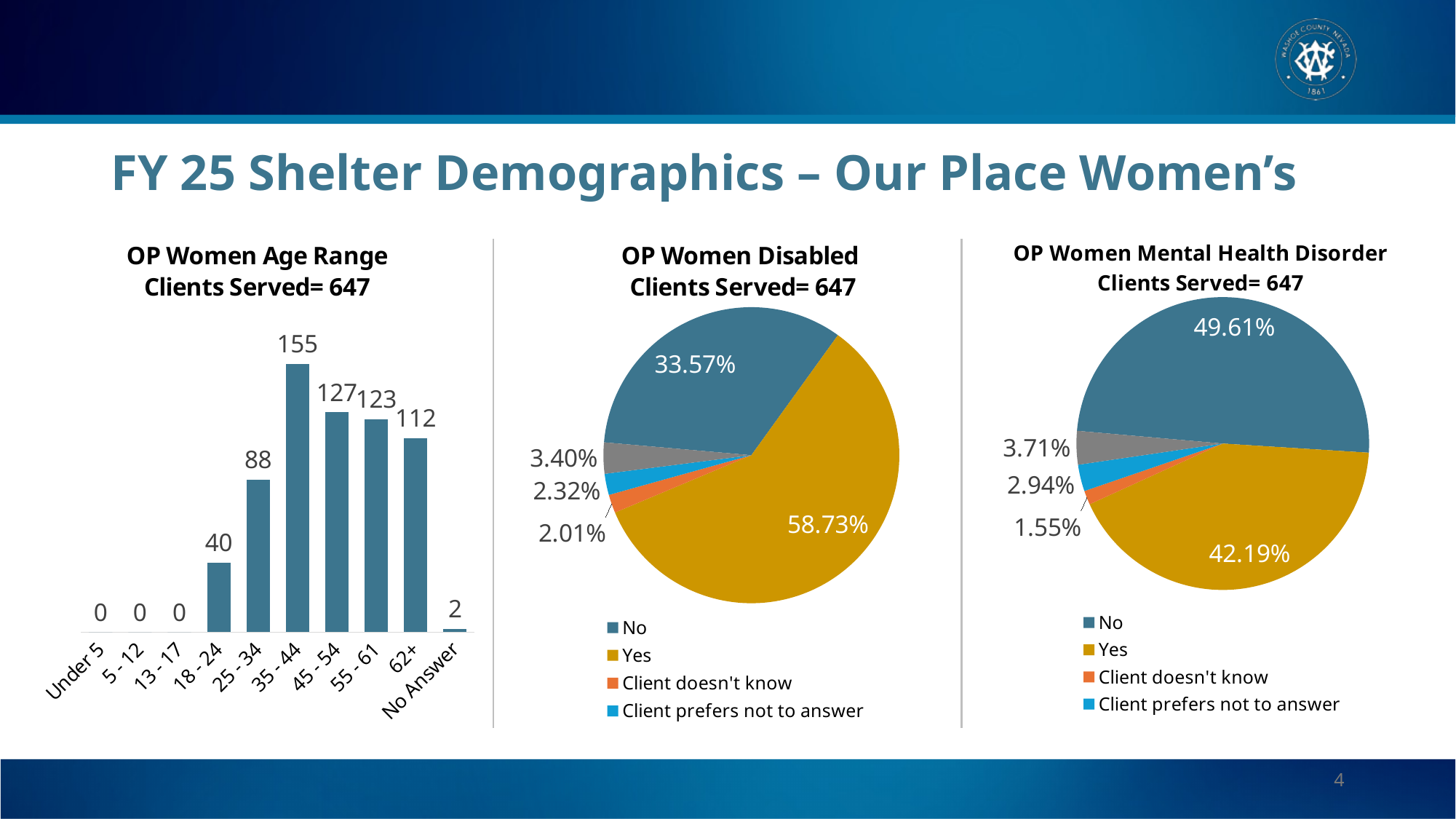
In the OP Women Age Range chart, what is the difference between the 35 - 44 and 25 - 34 values? 67 In the OP Women Disabled pie chart, what percentage is shown for Client doesn't know? 2.01% In the OP Women Age Range chart, which age range has the highest number of clients? 35 - 44 How many age categories are shown on the x axis of the OP Women Age Range chart? 10 In the OP Women Mental Health Disorder pie chart, what is the difference between the No and Yes shares? 7.42% In the OP Women Disabled pie chart, what share of clients answered Yes? 58.73% What kind of chart is the OP Women Age Range chart? Bar chart How many entries does the legend of the OP Women Mental Health Disorder pie chart list? 4 In the OP Women Mental Health Disorder pie chart, what share of clients answered No? 49.61% In the OP Women Age Range chart, which is larger, the value for 45 - 54 or the value for 62+? 45 - 54 In the OP Women Age Range chart, what is the value for the 18 - 24 category? 40 In the OP Women Age Range chart, how many clients were in the 35 - 44 age range? 155